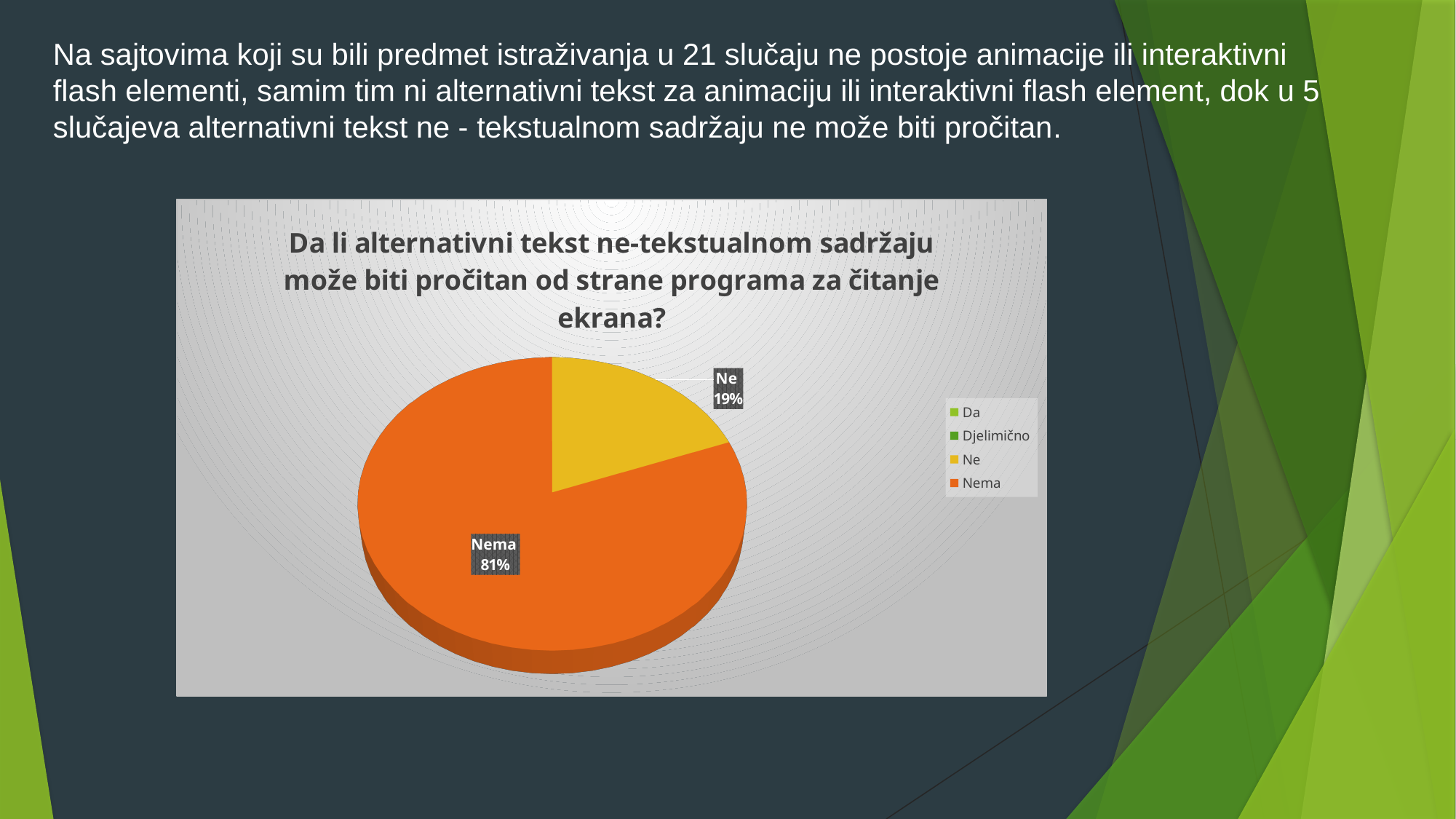
Which category has the largest slice of the pie? Nema Which of the two visible slices is smaller, "Ne" or "Nema"? Ne What share of the pie does the "Nema" slice represent? 81% What share of the pie does the "Ne" slice represent? 19% How many entries does the legend list? 4 What is the title of the chart? Da li alternativni tekst ne-tekstualnom sadržaju može biti pročitan od strane programa za čitanje ekrana? What is the difference in percentage points between the "Nema" slice and the "Ne" slice? 62 How many slices are visible in the pie? 2 Which is larger, the "Ne" slice or the "Nema" slice? Nema What kind of chart is shown on the slide? pie chart What colour is the "Nema" slice? orange